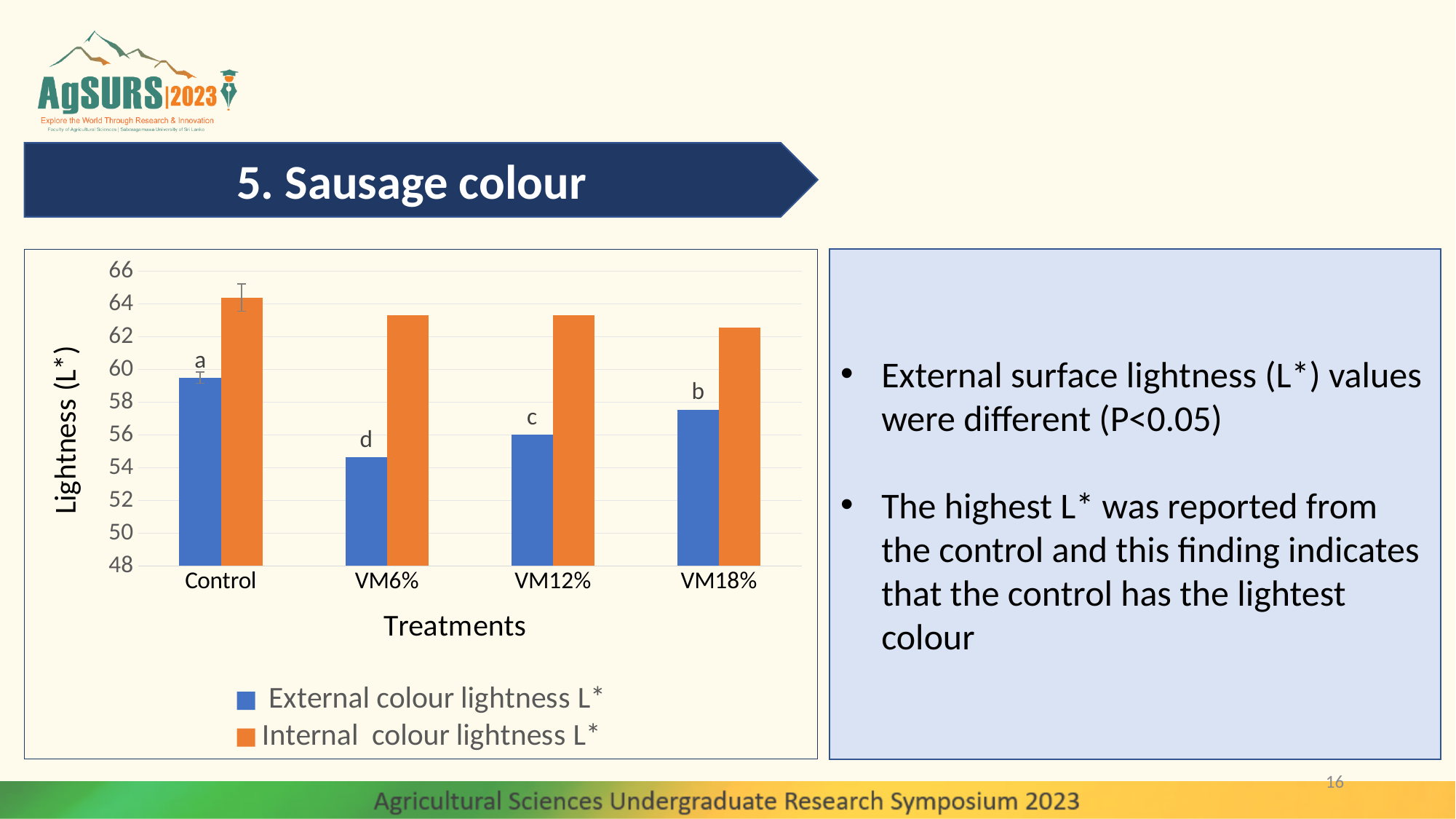
Which treatment has the highest Internal colour lightness L* value? Control How many series does the chart legend list? 2 Is the Internal colour lightness L* value for VM18% greater or less than 64? less What is the label of the y axis of the chart? Lightness (L*) Which treatment has the highest External colour lightness L* value? Control Which treatment has the lowest External colour lightness L* value? VM6% For the Control treatment, which is larger, the External colour lightness L* or the Internal colour lightness L*? Internal colour lightness L* Which is larger, the External colour lightness L* value for VM12% or for VM18%? VM18% How many treatments are shown on the x axis of the chart? 4 What kind of chart is shown on the slide? Bar chart Is the External colour lightness L* value for Control greater or less than 58? greater Is the External colour lightness L* value for VM6% greater or less than 56? less